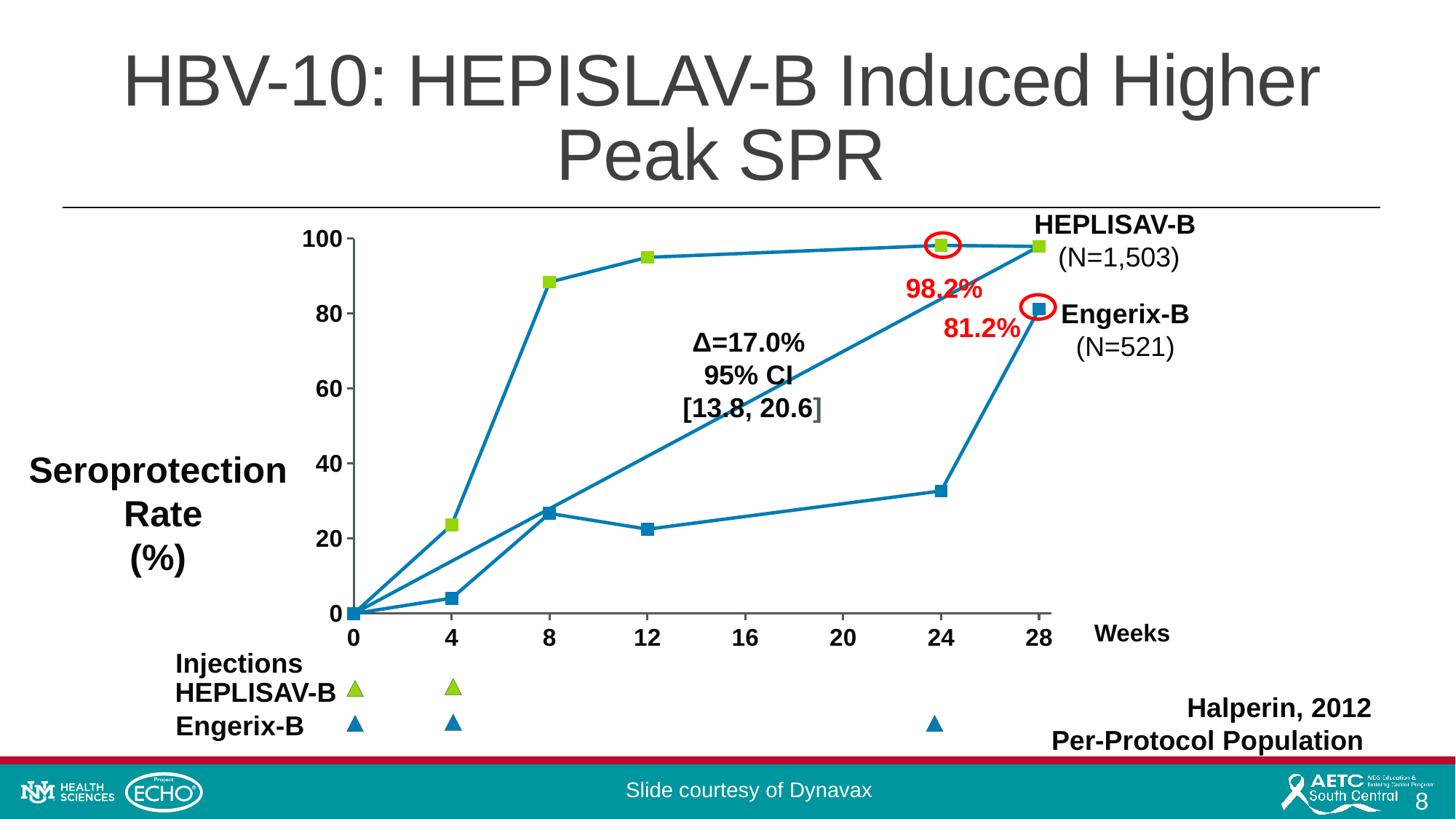
Is the seroprotection rate for Engerix-B at week 12 greater or less than 40? less What is the seroprotection rate for HEPLISAV-B at week 24? 98.2% Is the seroprotection rate for HEPLISAV-B at week 8 greater or less than 80? greater What kind of chart is shown on the slide? line chart What is the difference between the circled peak seroprotection rates of HEPLISAV-B (98.2%) and Engerix-B (81.2%)? 17.0% Is the seroprotection rate for HEPLISAV-B at week 4 greater or less than 40? less Does the HEPLISAV-B seroprotection rate rise or fall from week 0 to week 24? rise What is the seroprotection rate for Engerix-B at week 28? 81.2% How many vaccine series are plotted on the chart? 2 What is the label of the y axis of the chart? Seroprotection Rate (%) At week 8, which vaccine has the higher seroprotection rate, HEPLISAV-B or Engerix-B? HEPLISAV-B